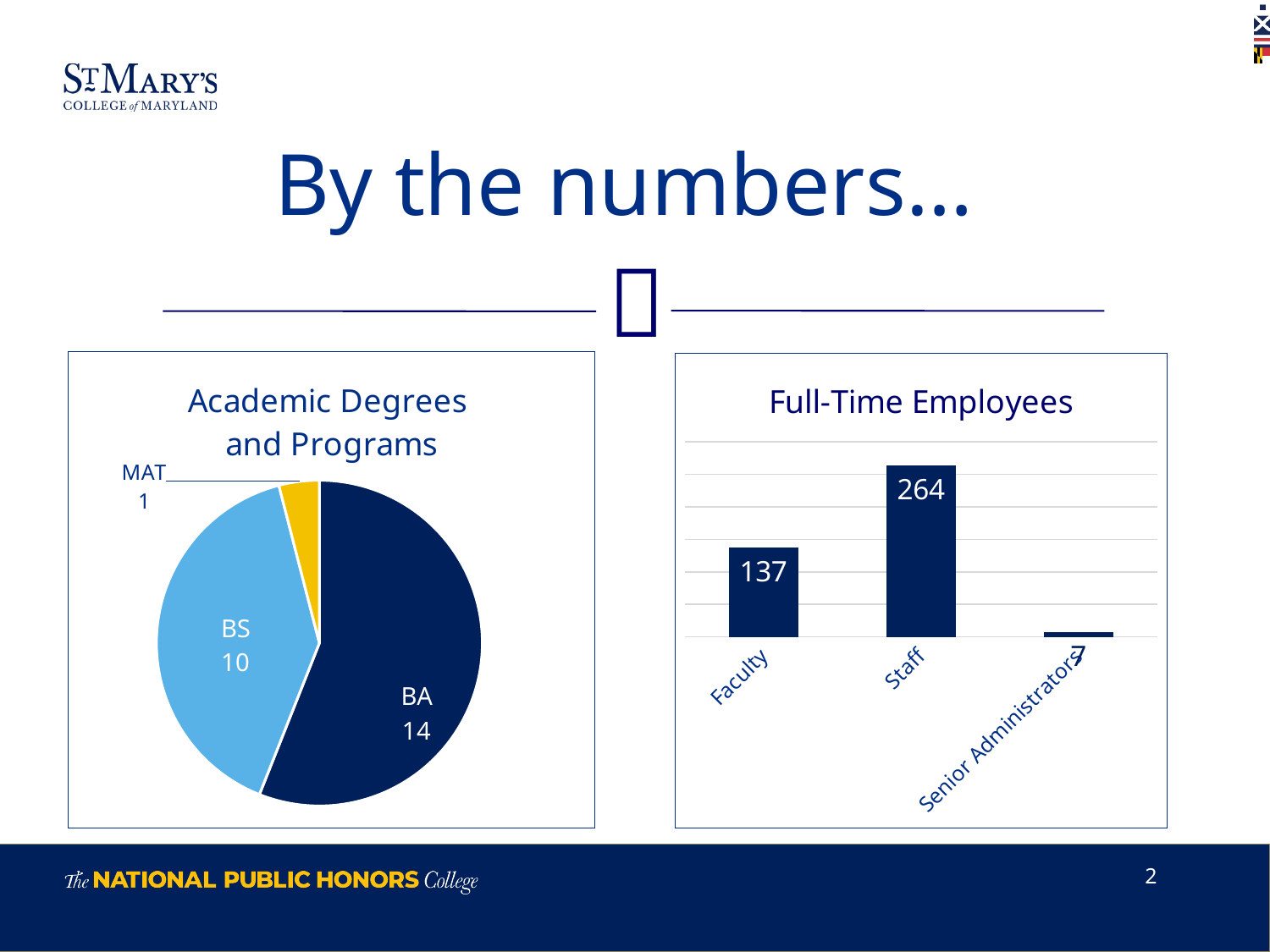
What kind of chart is the Full-Time Employees chart? Bar chart In the Full-Time Employees chart, which category has the highest value? Staff In the Academic Degrees and Programs chart, what is the value for BS? 10 In the Full-Time Employees chart, what is the value for Faculty? 137 In the Academic Degrees and Programs chart, what is the difference between the BA and BS values? 4 In the Academic Degrees and Programs chart, how many slices does the pie have? 3 In the Full-Time Employees chart, what is the value for Staff? 264 In the Academic Degrees and Programs chart, what is the value for BA? 14 In the Full-Time Employees chart, which category has the lowest value? Senior Administrators In the Full-Time Employees chart, what is the difference between the Staff and Faculty values? 127 What kind of chart is the Academic Degrees and Programs chart? Pie chart In the Academic Degrees and Programs chart, which category has the smallest slice? MAT